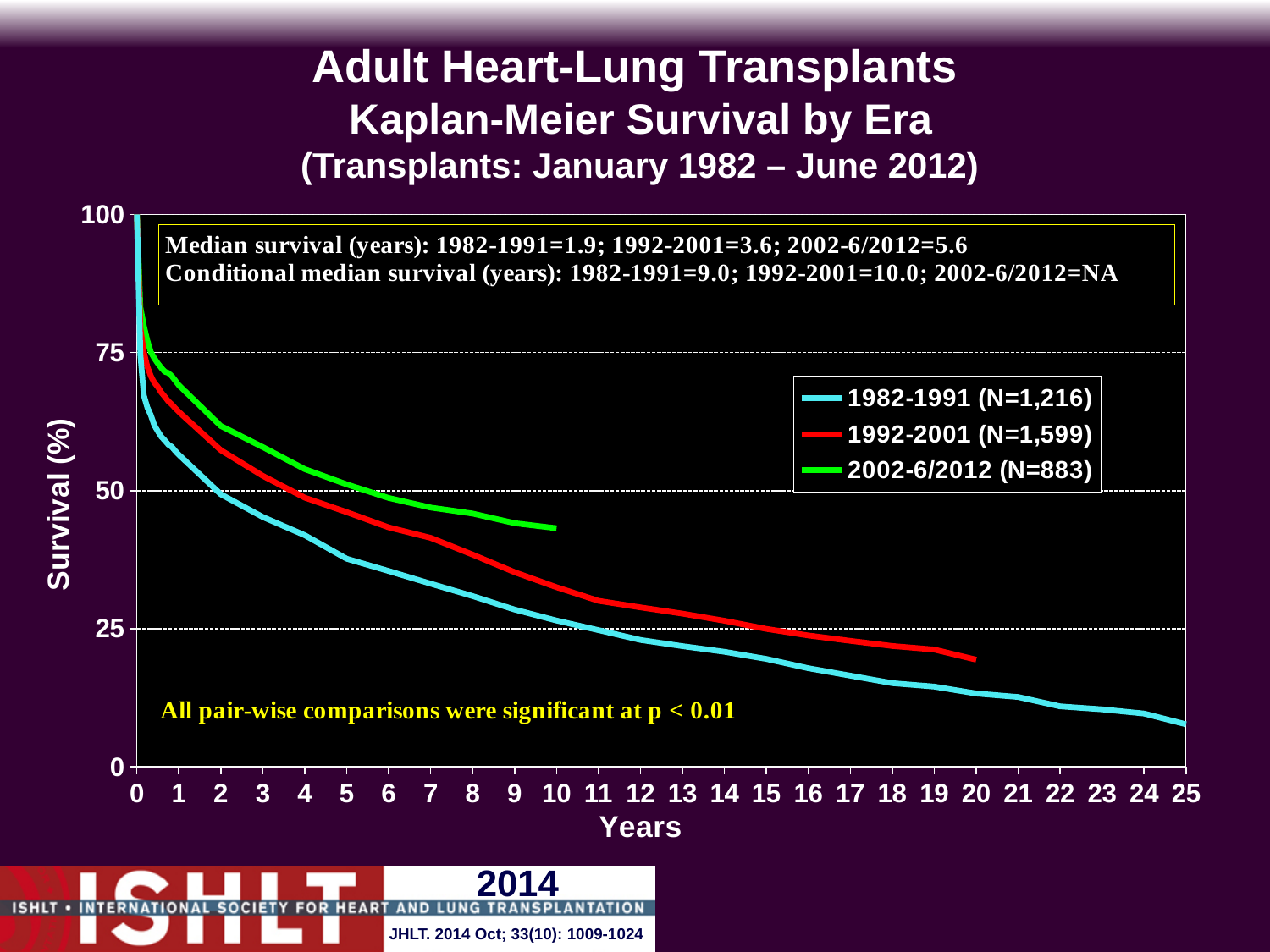
What is the number of transplants (N) for the 1992-2001 era shown in the legend? 1,599 Is the survival for the 1992-2001 era at 10 years greater or less than 25? greater Is the survival for the 1982-1991 era at 5 years greater or less than 50? less At 3 years, which era has the highest survival? 2002-6/2012 By how many years does the median survival of the 2002-6/2012 era exceed that of the 1982-1991 era? 3.7 What is the conditional median survival in years for the 1992-2001 era, as printed on the chart? 10.0 Is the survival for the 1982-1991 era at 20 years greater or less than 25? less What kind of chart is shown on the slide? line chart What is the median survival in years for the 2002-6/2012 era, as printed on the chart? 5.6 How many series does the legend list? 3 Do the survival curves rise or fall as years increase? fall Which era has the smallest N in the legend? 2002-6/2012 (N=883)